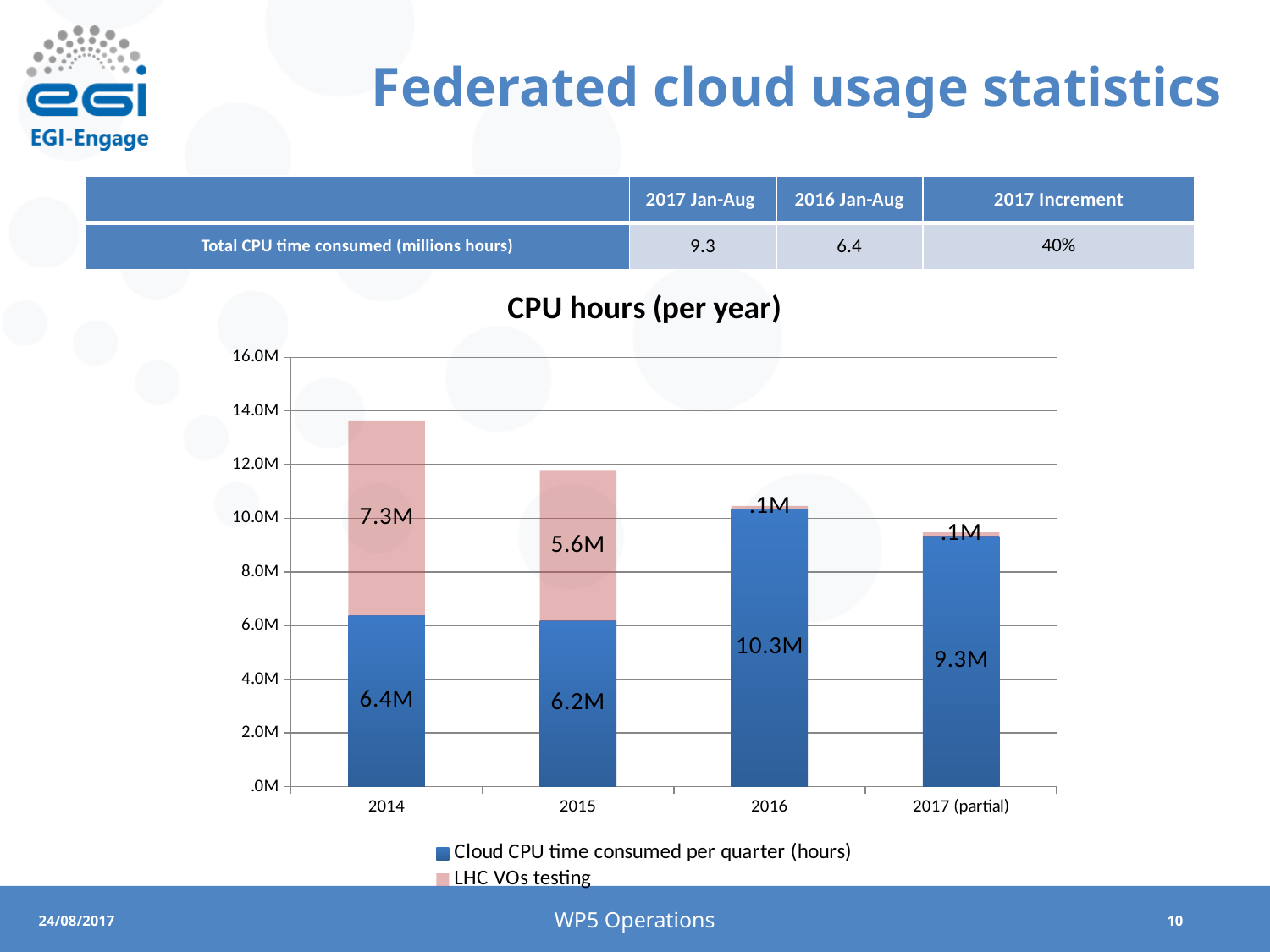
What is the value of Cloud CPU time consumed for 2016? 10.3M How many series does the legend list? 2 What is the Cloud CPU time consumed value for 2017 (partial)? 9.3M What is the difference between the Cloud CPU time consumed values for 2016 and 2017 (partial)? 1.0M Which is larger, the LHC VOs testing value for 2014 or for 2015? 2014 How many years (categories) are shown on the x axis? 4 What is the LHC VOs testing value for 2015? 5.6M What is the total of the stacked bar for 2014? 13.7M Which year has the highest Cloud CPU time consumed value? 2016 Which year has the lowest Cloud CPU time consumed value? 2015 What is the LHC VOs testing value for 2014? 7.3M What type of chart is shown on the slide? Stacked bar chart